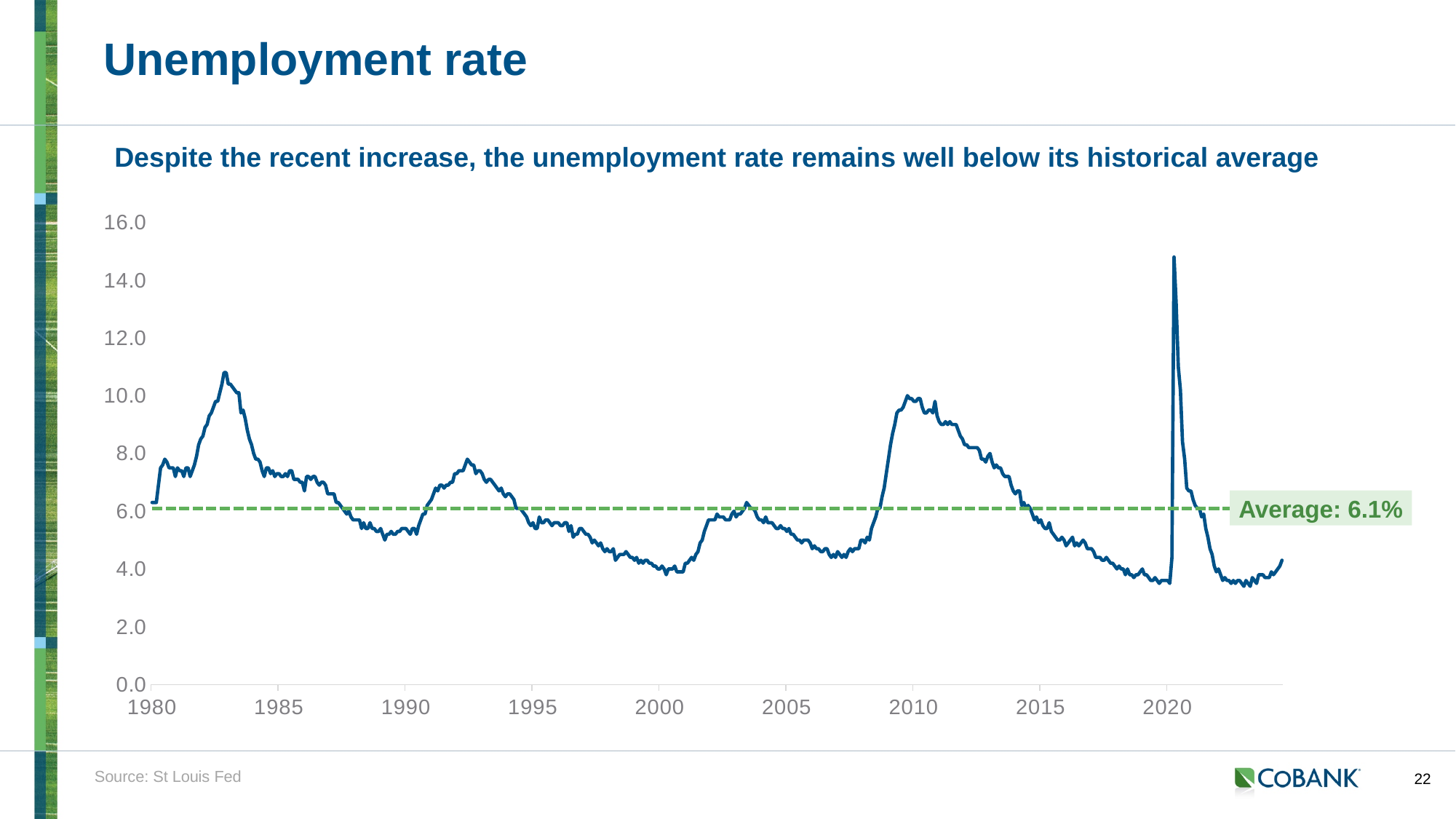
What is the source cited for the chart? St Louis Fed Is the peak unemployment rate around 1983 greater or less than 10.0? greater What kind of chart is shown on the slide? line chart Is the unemployment rate at the end of the series (around 2024) greater or less than 6.0? less Between 2010 and 2019, does the unemployment rate generally rise or fall? fall In which year does the unemployment rate reach its highest peak on the chart? 2020 What is the highest value shown on the y axis? 16.0 Is the peak unemployment rate around 2020 greater or less than 14.0? greater Between 2007 and 2010, does the unemployment rate rise or fall? rise What is the historical average unemployment rate marked by the dashed line? 6.1% Which is higher: the peak unemployment rate around 2020 or the peak around 1983? the peak around 2020